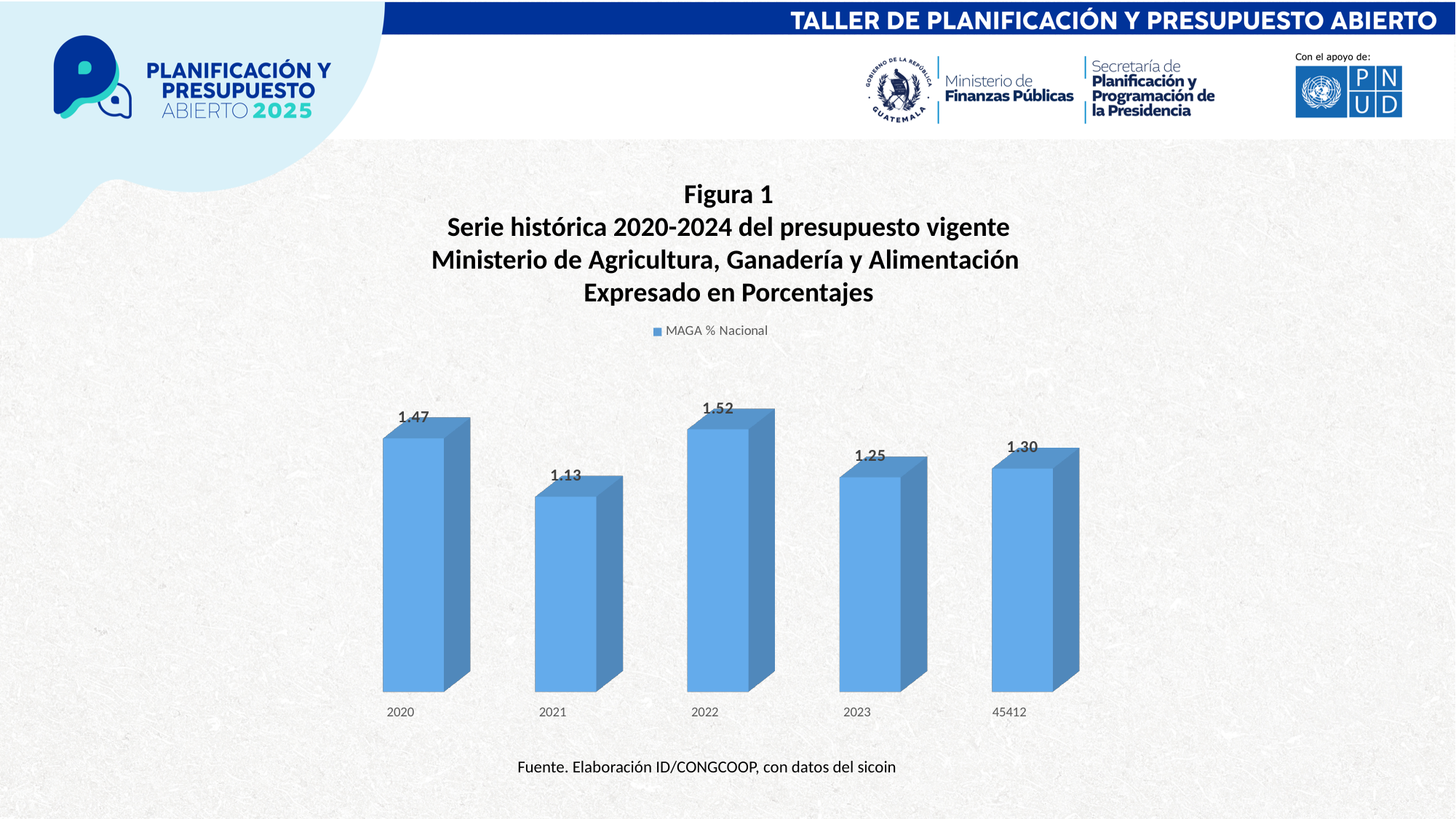
How many bars are shown in the chart? 5 What is the difference between the values for 2022 and 2021? 0.39 What is the value for 2021? 1.13 What is the value for the last bar, labelled 45412? 1.30 Which category has the lowest value? 2021 What kind of chart is shown on the slide? Bar chart Which is larger, the value for 2020 or the value for 2023? 2020 What is the value for 2020? 1.47 Which category has the highest value? 2022 What is the value for 2023? 1.25 How many series does the legend list? 1 What is the value for 2022? 1.52